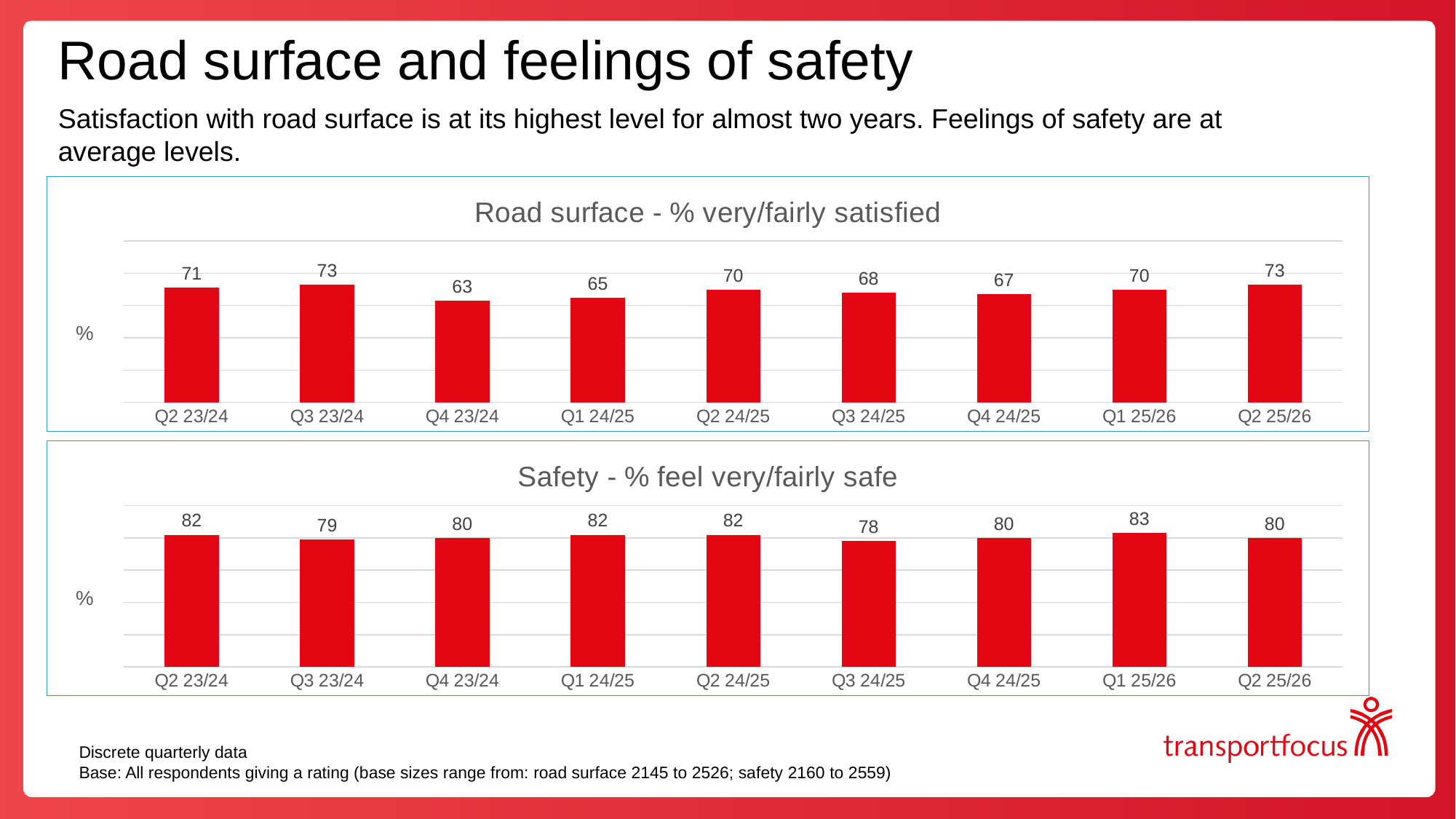
In the 'Road surface - % very/fairly satisfied' chart, what is the value for Q4 23/24? 63 In the 'Safety - % feel very/fairly safe' chart, what is the difference between the values for Q1 25/26 and Q3 24/25? 5 How many quarters are shown in the 'Safety - % feel very/fairly safe' chart? 9 In the 'Safety - % feel very/fairly safe' chart, which quarter has the lowest value? Q3 24/25 In the 'Road surface - % very/fairly satisfied' chart, which is larger: the value for Q2 24/25 or Q3 24/25? Q2 24/25 In the 'Road surface - % very/fairly satisfied' chart, which quarter has the lowest value? Q4 23/24 What type of chart is the 'Road surface - % very/fairly satisfied' chart? Bar chart In the 'Road surface - % very/fairly satisfied' chart, do the values rise or fall from Q4 24/25 to Q2 25/26? Rise In the 'Safety - % feel very/fairly safe' chart, which quarter has the highest value? Q1 25/26 What colour are the bars in the 'Safety - % feel very/fairly safe' chart? Red In the 'Safety - % feel very/fairly safe' chart, what is the value for Q1 25/26? 83 In the 'Road surface - % very/fairly satisfied' chart, what is the difference between the values for Q2 25/26 and Q4 23/24? 10